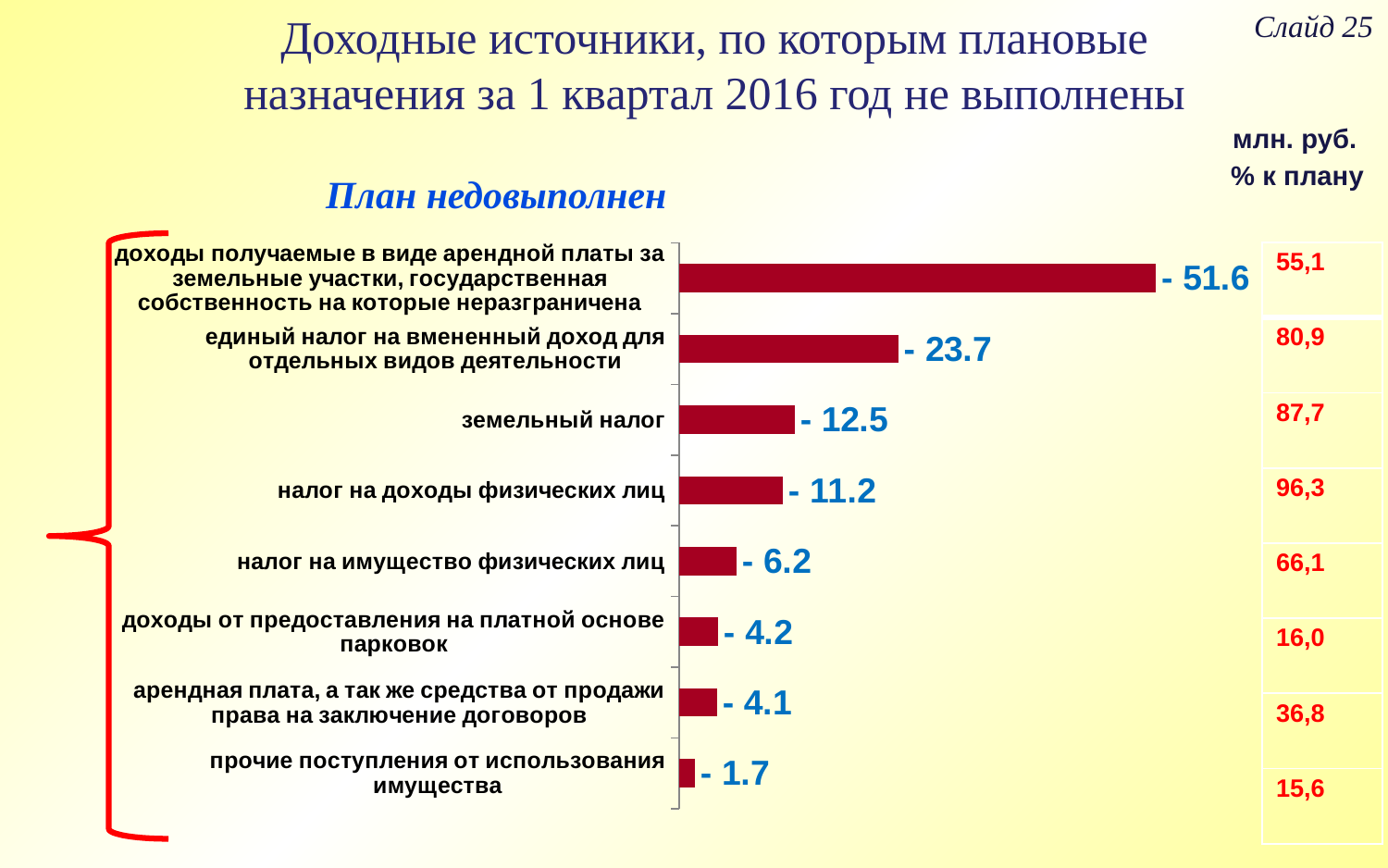
By how much does the bar for «доходы получаемые в виде арендной платы за земельные участки...» (51.6) exceed the bar for «единый налог на вмененный доход...» (23.7)? 27.9 What is the blue subtitle written above the chart? План недовыполнен What is the value shown for «налог на доходы физических лиц»? - 11.2 What is the value shown for «доходы от предоставления на платной основе парковок»? - 4.2 What kind of chart is shown on the slide? bar chart Which category has the longest bar in the chart? доходы получаемые в виде арендной платы за земельные участки, государственная собственность на которые неразграничена What is the difference between the values for «земельный налог» (12.5) and «налог на доходы физических лиц» (11.2)? 1.3 Which bar is longer: «налог на имущество физических лиц» or «прочие поступления от использования имущества»? налог на имущество физических лиц Which category has the shortest bar in the chart? прочие поступления от использования имущества How many categories are plotted in the chart? 8 What is the value shown for «единый налог на вмененный доход для отдельных видов деятельности»? - 23.7 What is the value shown for «земельный налог»? - 12.5